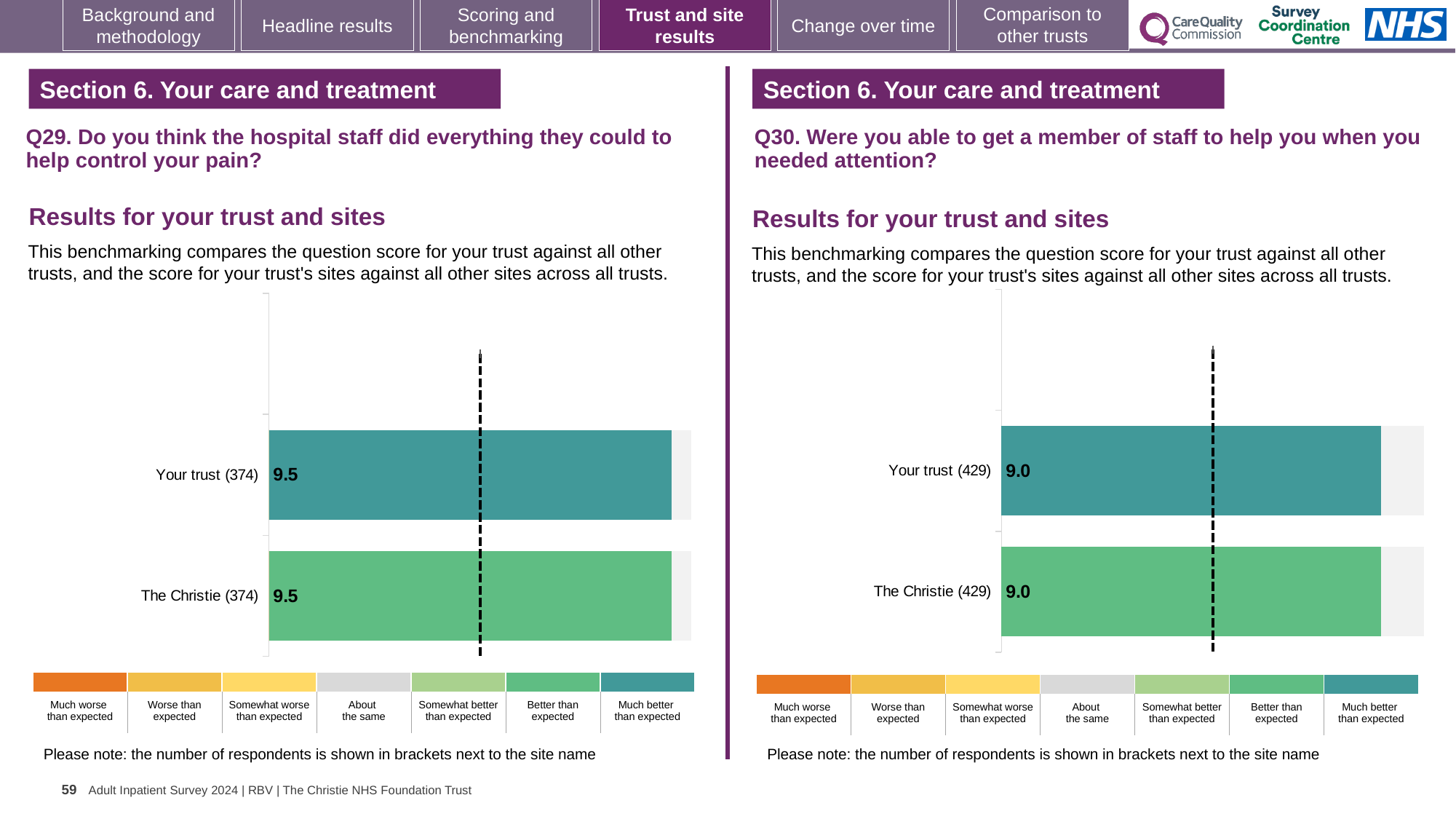
On the Q29 chart (left), what is the score for Your trust (374)? 9.5 On the Q30 chart (right), what is the difference between the score for Your trust and the score for The Christie? 0.0 How many bars are plotted on the Q30 chart (right)? 2 How many respondents are shown in brackets for Your trust on the Q30 chart (right)? 429 On the Q30 chart (right), what is the score for Your trust (429)? 9.0 On the Q29 chart (left), what is the difference between the score for Your trust and the score for The Christie? 0.0 How many bars are plotted on the Q29 chart (left)? 2 On the Q30 chart (right), what is the score for The Christie (429)? 9.0 On the Q29 chart (left), what is the score for The Christie (374)? 9.5 What kind of chart is used on the Q30 chart (right)? Bar chart Is the score for Your trust on the Q29 chart (left) higher than the score for Your trust on the Q30 chart (right)? Yes How many categories does the colour key below the Q29 chart (left) list? 7